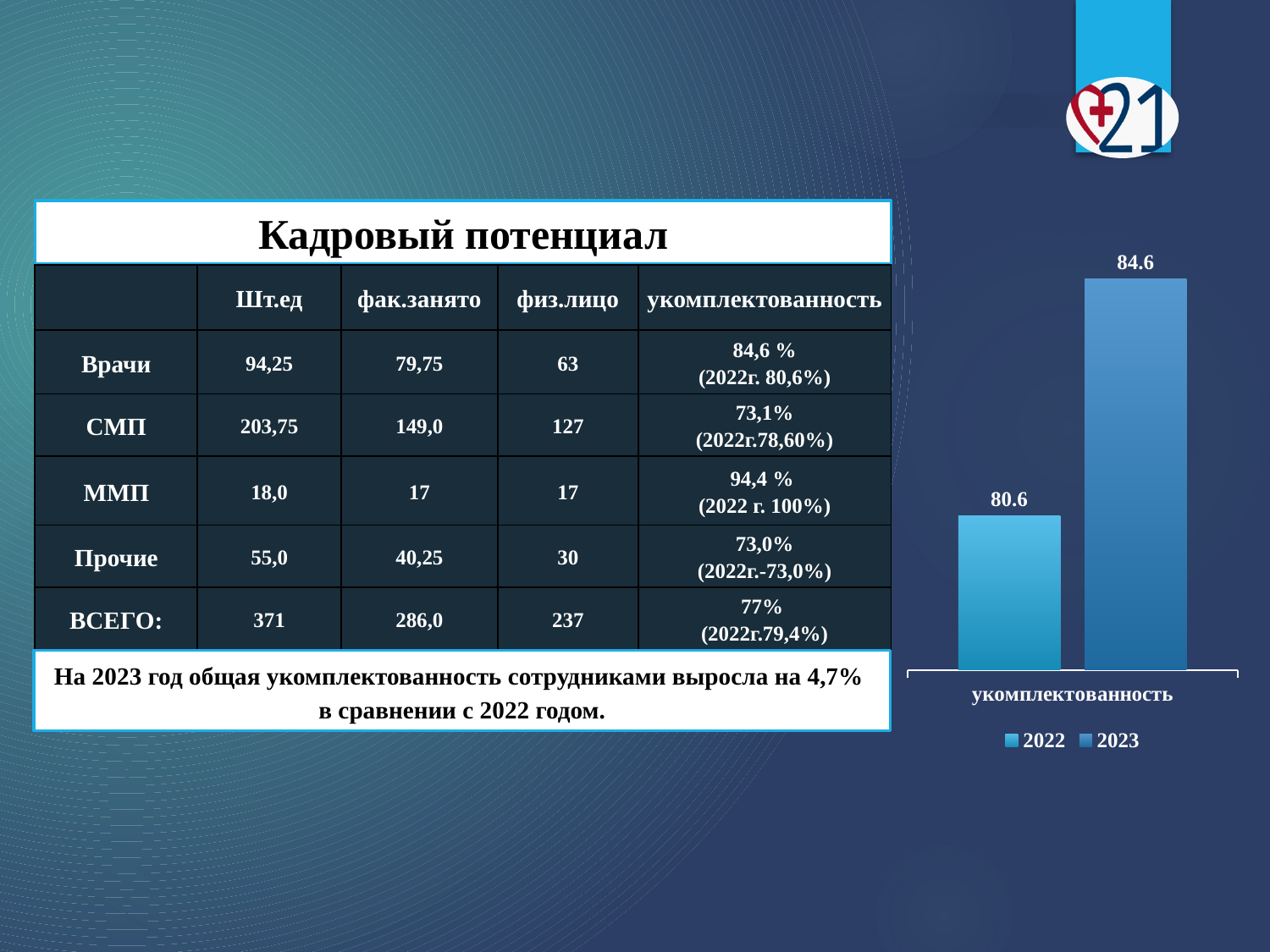
What entries does the legend of the bar chart list? 2022, 2023 How many categories are shown on the x axis of the bar chart? 1 How many series does the legend of the bar chart list? 2 Which series has the higher value in the bar chart, 2022 or 2023? 2023 What kind of chart is shown on the right of the slide? bar chart What is the value for 2023 in the bar chart? 84.6 What is the value for 2022 in the bar chart? 80.6 What is the category label on the x axis of the bar chart? укомплектованность Which series has the lowest value in the bar chart? 2022 Which series has the highest value in the bar chart? 2023 What is the difference between the 2023 and 2022 values in the bar chart? 4 Does the value rise or fall from 2022 to 2023 in the bar chart? rise